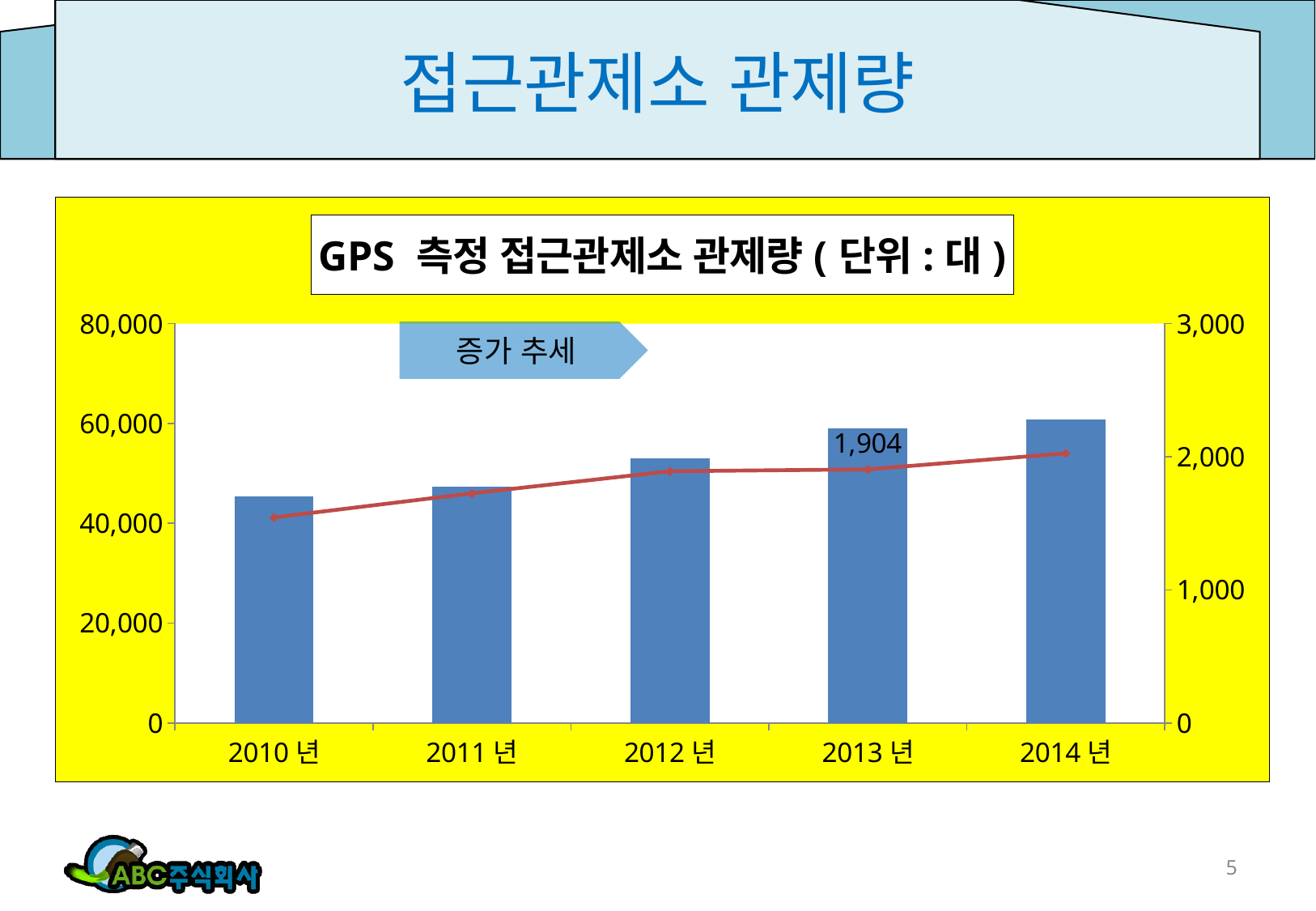
How many years are shown on the x axis? 5 Is the bar value for 2010 년 greater or less than 40,000? greater What text is written in the arrow annotation on the chart? 증가 추세 Is the bar value for 2012 년 greater or less than 60,000? less Is the line value for 2010 년 greater or less than 2,000 on the right axis? less What kind of chart is shown? bar chart with a line Which year has the lowest bar? 2010 년 What is the title of the chart? GPS 측정 접근관제소 관제량 ( 단위 : 대 ) Do the bar values rise or fall from 2010 년 to 2014 년? rise Which bar is taller, 2010 년 or 2012 년? 2012 년 What is the value of the line series for 2013 년? 1,904